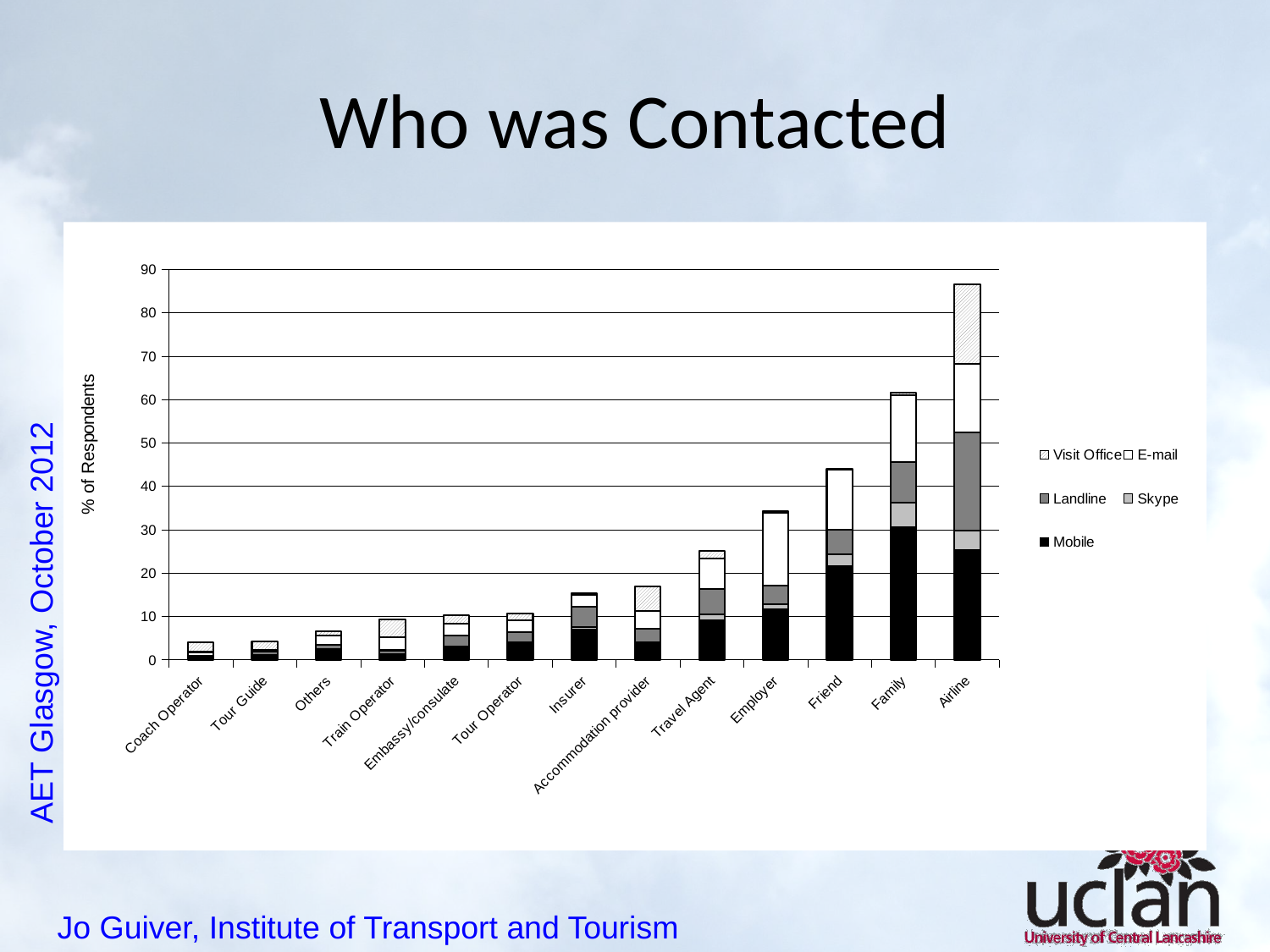
Is the total value for Coach Operator greater or less than 10? less How many series does the chart's legend list? 5 Is the total value for Family greater or less than 60? greater Which has the larger total bar, Family or Friend? Family How many categories are shown on the x axis of the chart? 13 What is the label on the chart's vertical axis? % of Respondents Is the total value for Friend greater or less than 50? less Do the total bar heights generally rise or fall from left to right along the x axis? rise What kind of chart is shown on the slide? stacked bar chart Which category has the highest total bar? Airline